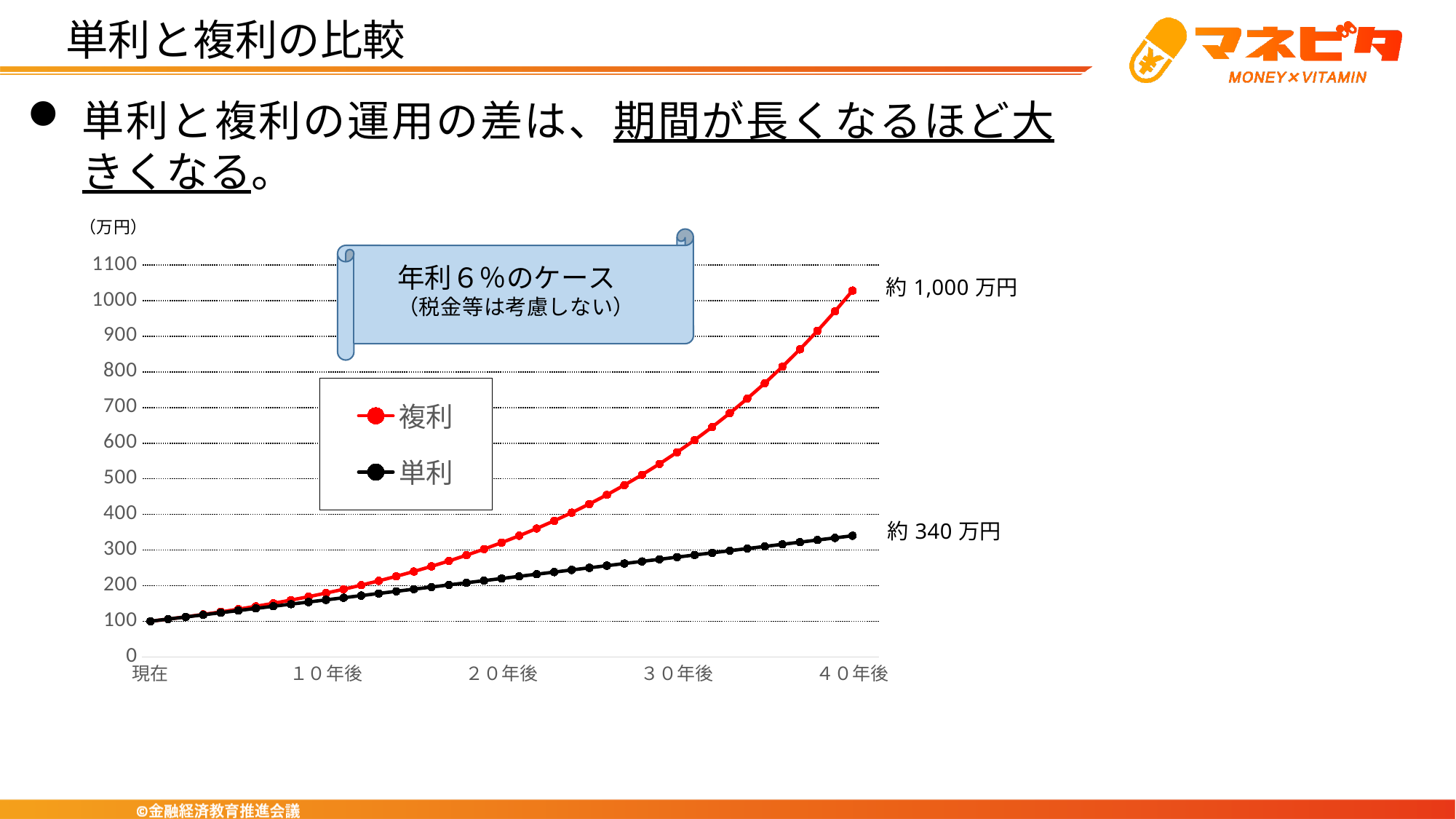
Is the value of the 単利 line at 20年後 greater or less than 300? less Which series reaches the higher value at 40年後, 複利 or 単利? 複利 Is the value of the 複利 line at 20年後 greater or less than 400? less What annual interest rate does the callout on the chart say is assumed? 年利６％ How many labelled points are there on the x axis? 5 What annotation is printed at the end of the 複利 line? 約 1,000 万円 Do the values of the 複利 line rise or fall from 現在 to 40年後? rise How many series does the legend list? 2 What is the starting value (at 現在) of both lines, in 万円? 100 Is the value of the 単利 line at 40年後 greater or less than 400? less What kind of chart is shown on the slide? line chart